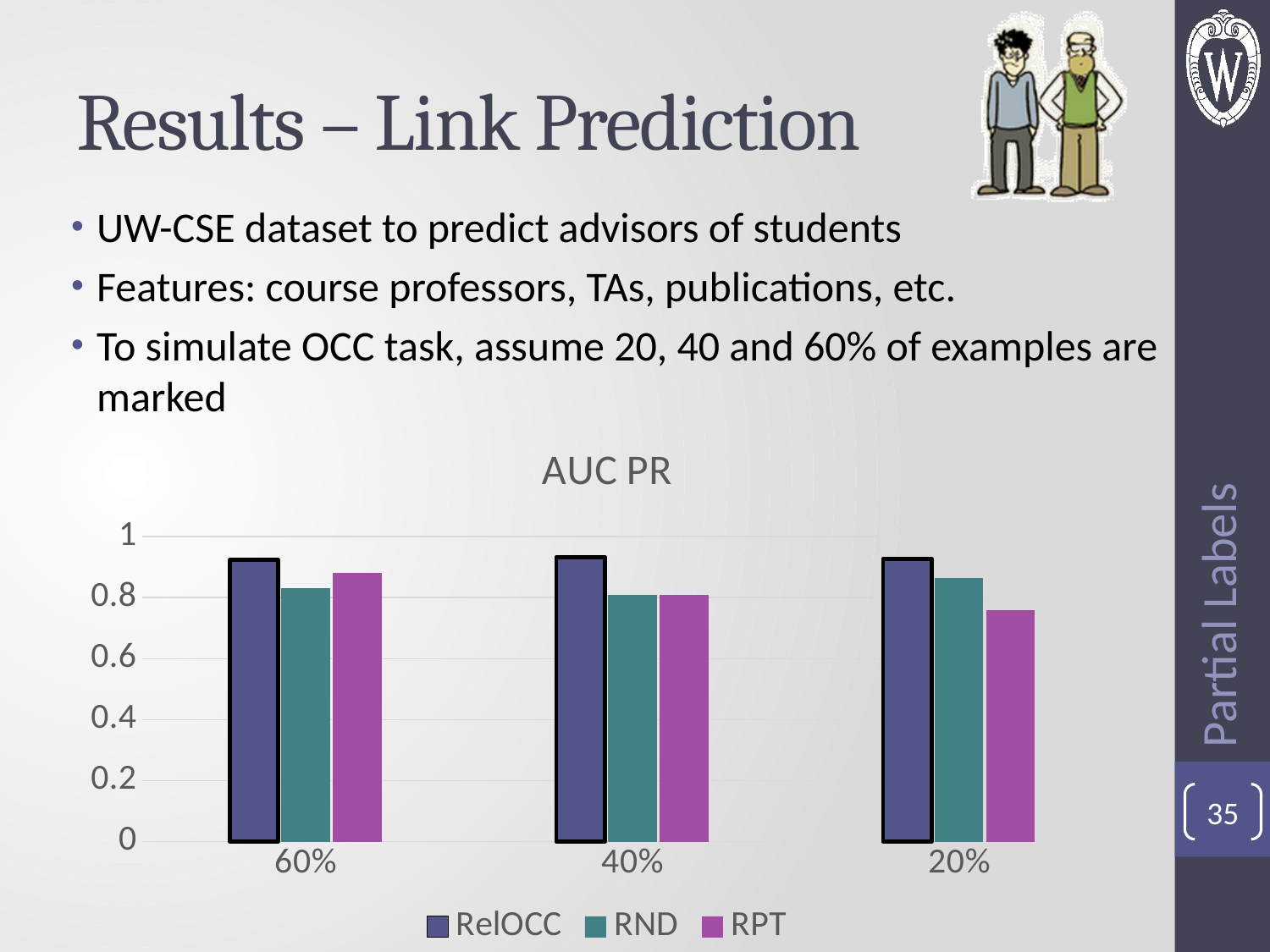
Which series are listed in the legend? RelOCC, RND, RPT Which series has the lowest value in the 60% category? RND What kind of chart is shown on the slide? bar chart How many categories are shown on the x axis? 3 What is the title of the chart? AUC PR In the 20% category, which is larger, RND or RPT? RND Is the value for RPT at 20% greater or less than 0.8? less Which series has the highest value in the 20% category? RelOCC Is the value for RelOCC at 60% greater or less than 0.8? greater Do the RPT values rise or fall moving from 60% to 20% along the x axis? fall How many series does the legend list? 3 Is the value for RND at 40% greater or less than 0.6? greater